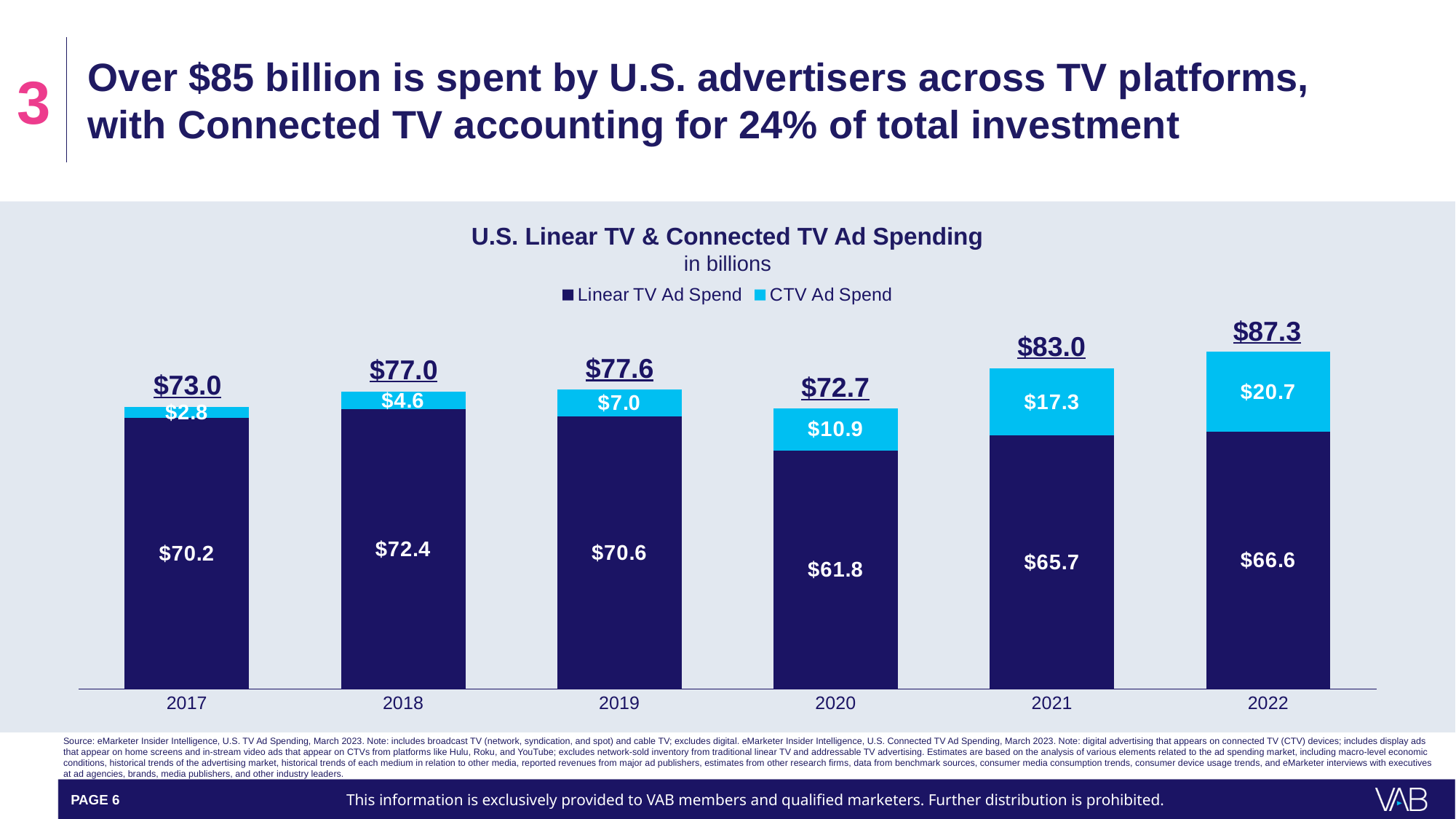
What is the difference between the CTV Ad Spend in 2022 and in 2017? $17.9 Does the CTV Ad Spend rise or fall from 2017 to 2022? Rise How many series does the legend list? 2 What is the CTV Ad Spend value for 2021? $17.3 What is the title of the chart? U.S. Linear TV & Connected TV Ad Spending What is the total ad spending shown above the 2022 bar? $87.3 Which is larger, the Linear TV Ad Spend in 2018 or in 2019? 2018 Which year has the lowest Linear TV Ad Spend? 2020 Which year has the highest CTV Ad Spend? 2022 What kind of chart is shown on the slide? Stacked bar chart How many years are shown on the x axis? 6 What is the Linear TV Ad Spend value for 2020? $61.8